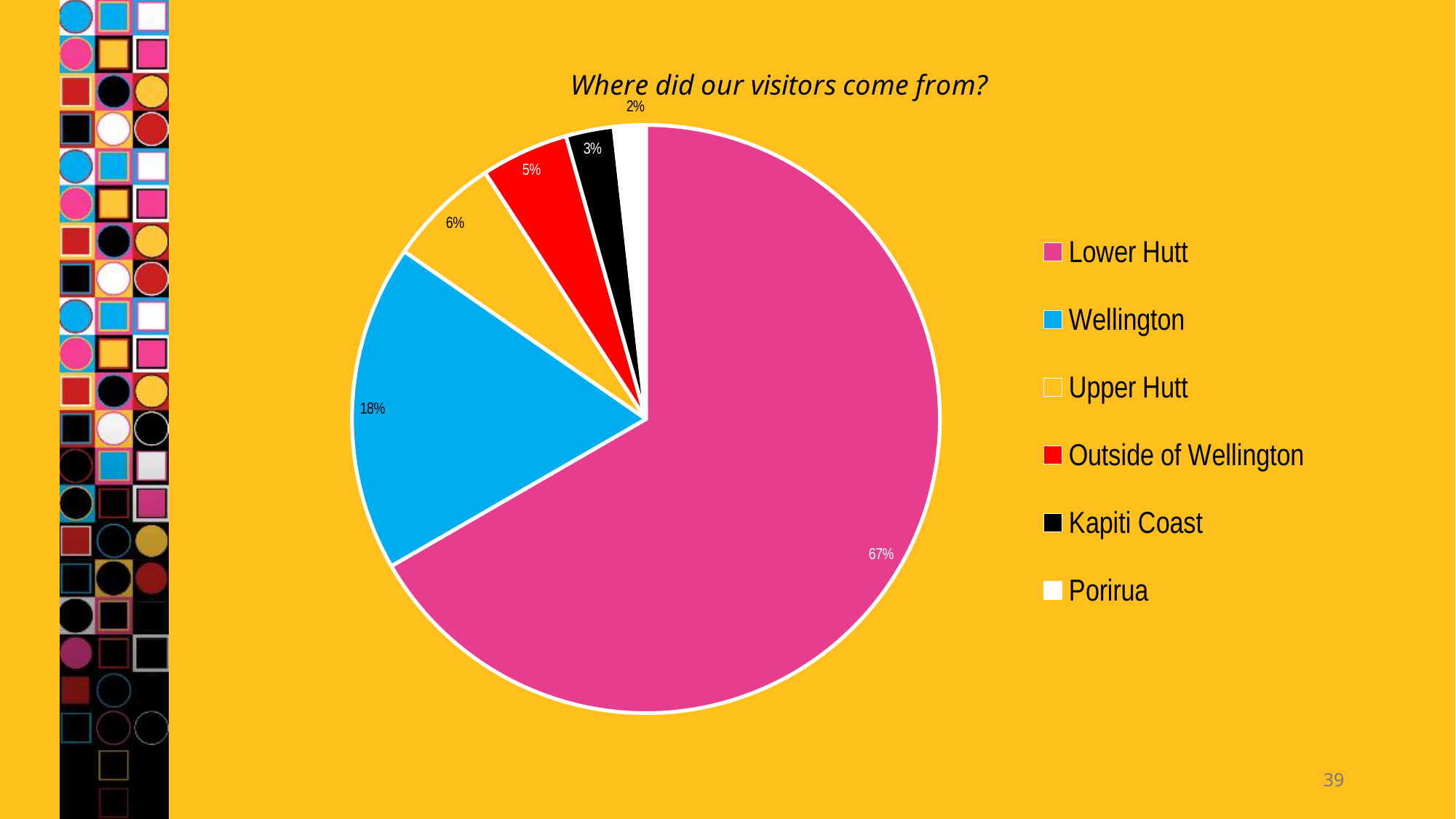
What is the title of the chart? Where did our visitors come from? What percentage of visitors came from Porirua? 2% What percentage of visitors came from Kapiti Coast? 3% What percentage of visitors came from Outside of Wellington? 5% What kind of chart is shown on the slide? pie chart What percentage of visitors came from Wellington? 18% What percentage of visitors came from Lower Hutt? 67% Which origin has the largest share of visitors? Lower Hutt What is the difference in percentage points between the Lower Hutt and Wellington shares? 49 What percentage of visitors came from Upper Hutt? 6% How many categories does the legend list? 6 Which origin has the smallest share of visitors? Porirua